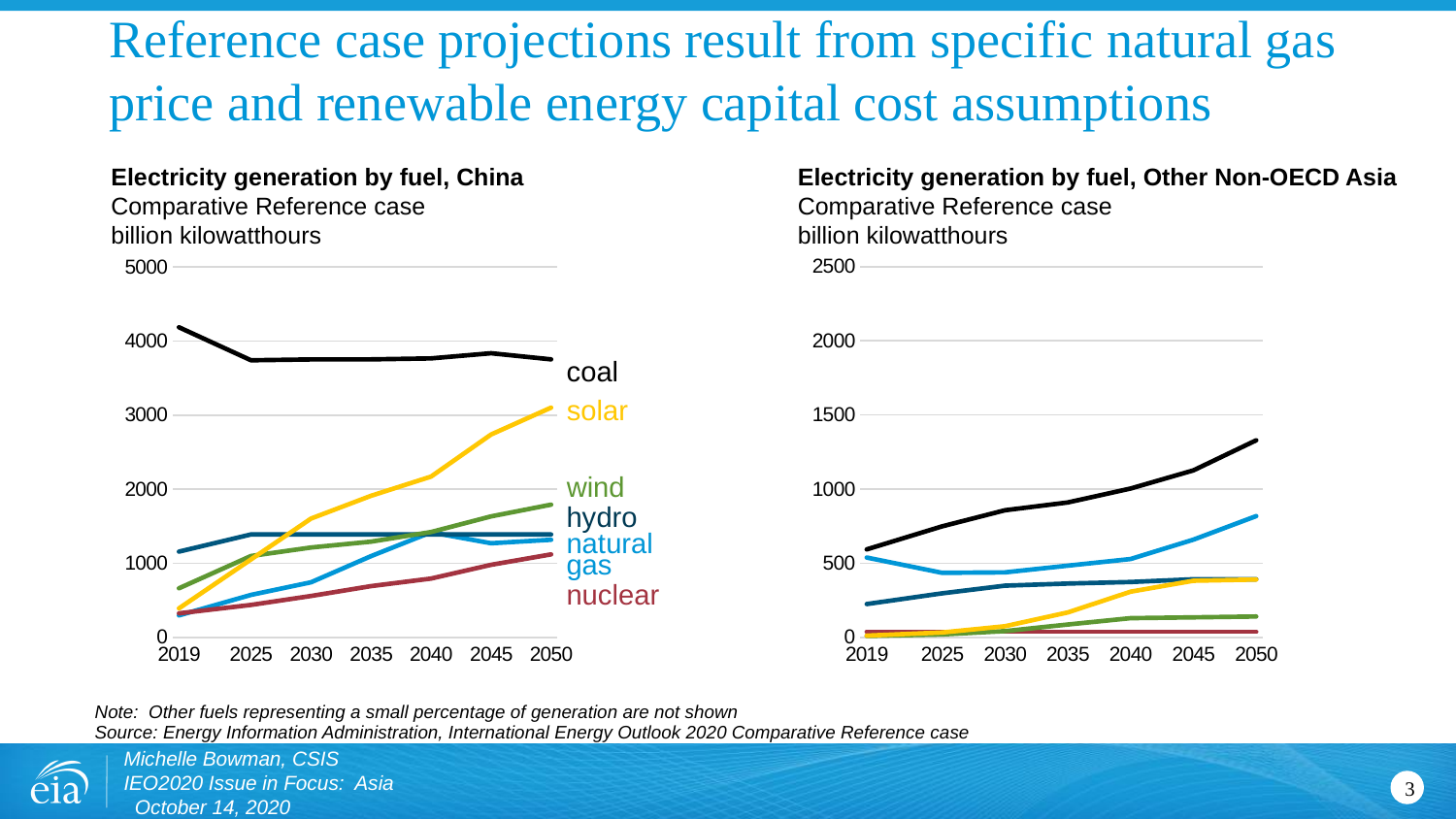
In the 'Electricity generation by fuel, China' chart, is the value for coal in 2019 greater or less than 4000? greater In the 'Electricity generation by fuel, China' chart, is the value for solar in 2050 greater or less than 2000? greater In the 'Electricity generation by fuel, Other Non-OECD Asia' chart, is the value of the black line in 2050 greater or less than 1000? greater What kind of chart is the 'Electricity generation by fuel, China' chart? line chart In the 'Electricity generation by fuel, Other Non-OECD Asia' chart, does the black line rise or fall from 2019 to 2050? rise In the 'Electricity generation by fuel, China' chart, which fuel has the highest generation in 2050? coal In the 'Electricity generation by fuel, China' chart, how many fuel series are labelled? 6 In the 'Electricity generation by fuel, China' chart, how many years are marked on the x axis? 7 What unit is used on the y axis of the 'Electricity generation by fuel, Other Non-OECD Asia' chart? billion kilowatthours In the 'Electricity generation by fuel, China' chart, does solar generation rise or fall from 2019 to 2050? rise In the 'Electricity generation by fuel, China' chart, which is larger in 2050, wind or hydro? wind